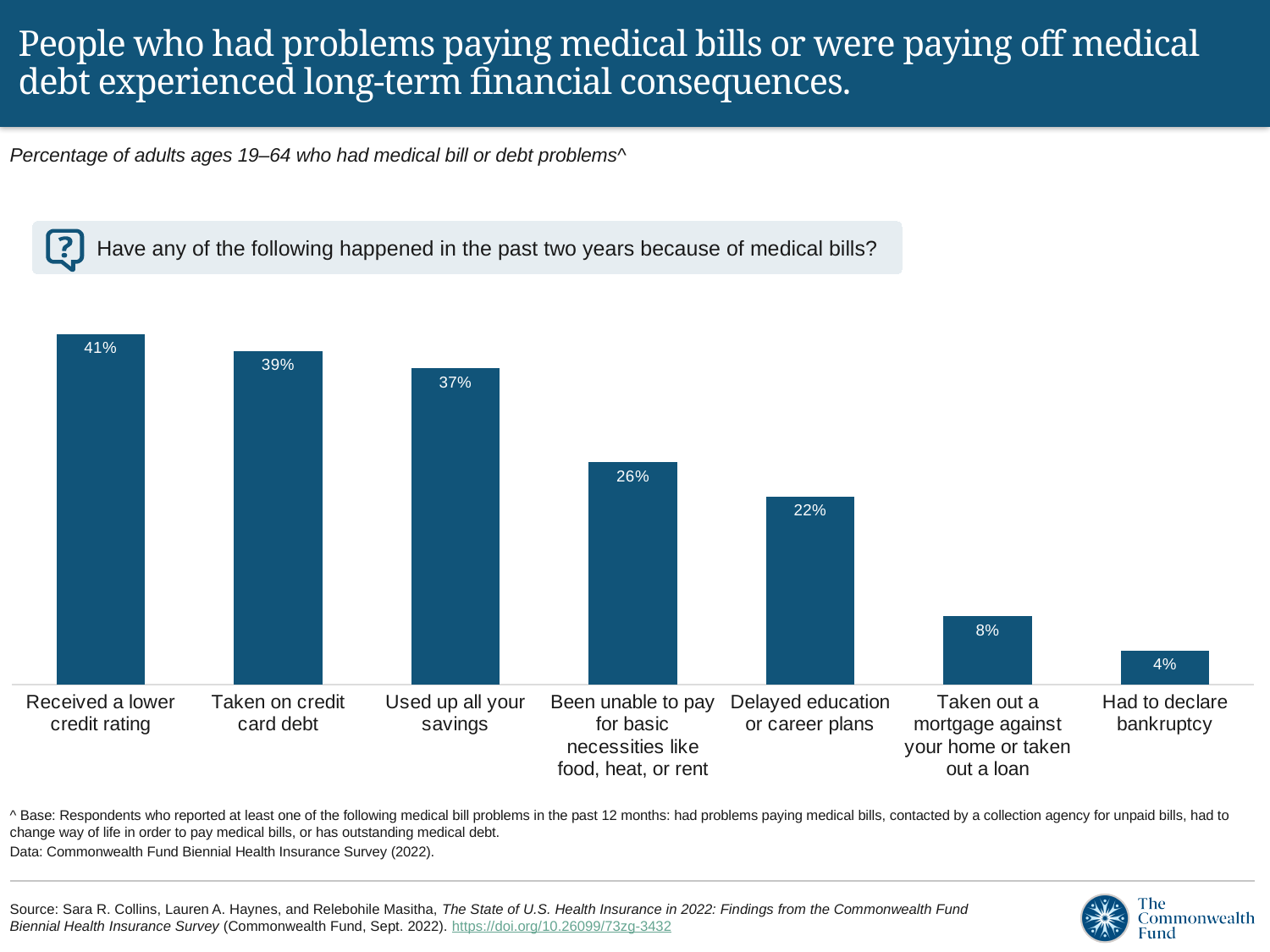
What percentage of adults with medical bill or debt problems had taken on credit card debt? 39% Which is larger: the percentage who used up all their savings or the percentage who delayed education or career plans? Used up all your savings What percentage of adults with medical bill or debt problems had to declare bankruptcy? 4% What percentage of adults with medical bill or debt problems had used up all their savings? 37% How many consequence categories are shown in the chart? 7 What percentage of adults with medical bill or debt problems received a lower credit rating? 41% What type of chart is shown on the slide? Bar chart What percentage of adults with medical bill or debt problems had delayed education or career plans? 22% What is the difference in percentage points between 'Been unable to pay for basic necessities like food, heat, or rent' and 'Taken out a mortgage against your home or taken out a loan'? 18 percentage points Do the values rise or fall moving from left to right across the chart? Fall Which consequence has the highest percentage in the chart? Received a lower credit rating Which consequence has the lowest percentage in the chart? Had to declare bankruptcy